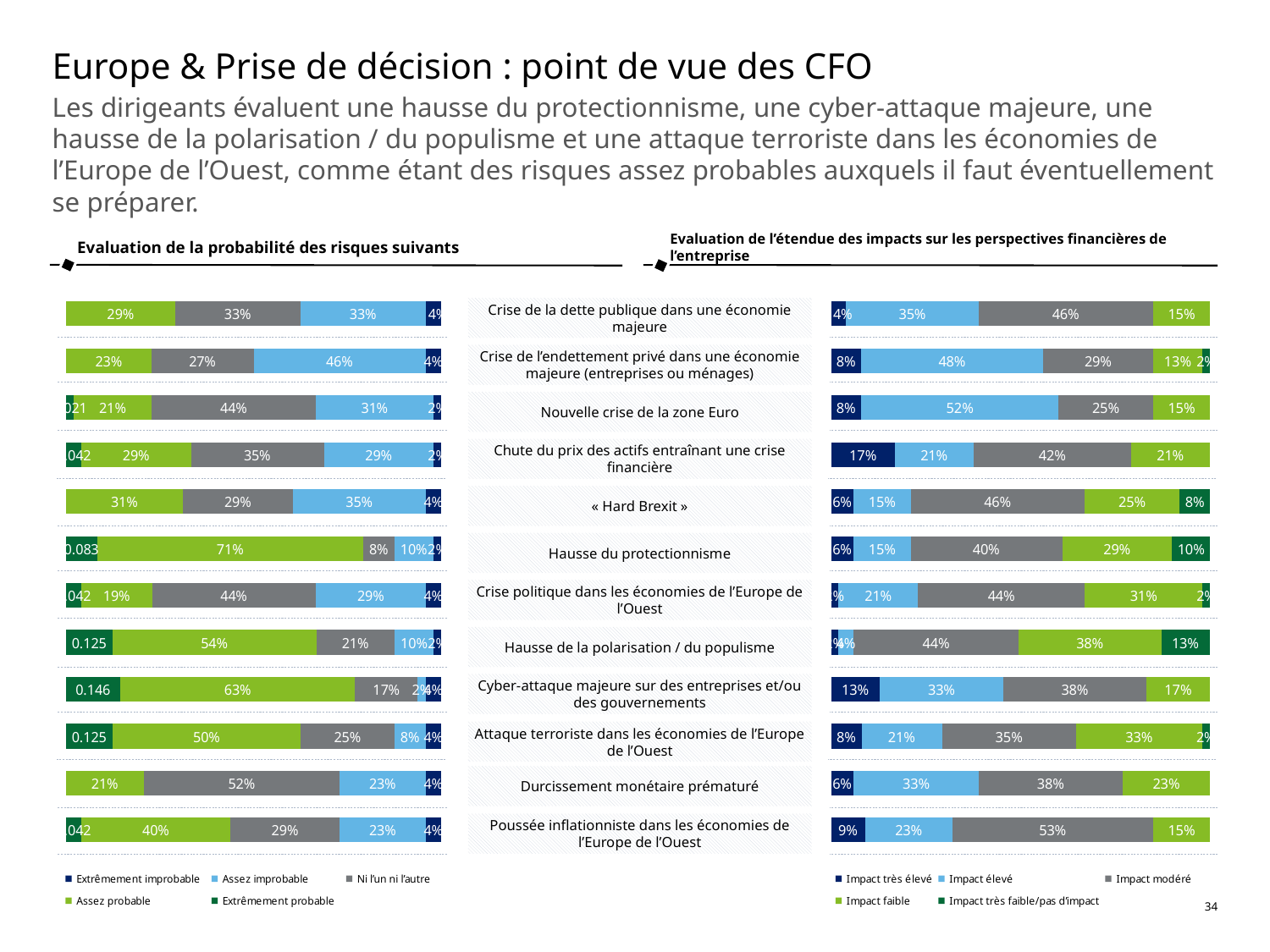
How many risk categories are plotted in the left-hand chart, 'Evaluation de la probabilité des risques suivants'? 12 In the right-hand chart on impacts, which risk has the highest 'Impact élevé' value? Nouvelle crise de la zone Euro What is the title of the left-hand chart? Evaluation de la probabilité des risques suivants In the left-hand chart on probability, what is the 'Ni l'un ni l'autre' value for 'Durcissement monétaire prématuré'? 52% In the right-hand chart on impacts, what is the 'Impact modéré' value for 'Poussée inflationniste dans les économies de l'Europe de l'Ouest'? 53% In the right-hand chart on impacts, which has the larger 'Impact très élevé' value: 'Cyber-attaque majeure sur des entreprises et/ou des gouvernements' or 'Attaque terroriste dans les économies de l'Europe de l'Ouest'? Cyber-attaque majeure sur des entreprises et/ou des gouvernements How many series does the legend of the left-hand chart, 'Evaluation de la probabilité des risques suivants', list? 5 In the right-hand chart on impacts, what is the difference between the 'Impact modéré' values for 'Poussée inflationniste dans les économies de l'Europe de l'Ouest' and '« Hard Brexit »'? 7 percentage points What kind of chart is the right-hand chart, 'Evaluation de l'étendue des impacts sur les perspectives financières de l'entreprise'? Stacked bar chart In the left-hand chart on probability, what is the 'Assez probable' value for 'Hausse du protectionnisme'? 71% In the right-hand chart on impacts, what is the 'Impact très élevé' value for 'Chute du prix des actifs entraînant une crise financière'? 17% In the right-hand chart on impacts, what is the 'Impact élevé' value for 'Nouvelle crise de la zone Euro'? 52%